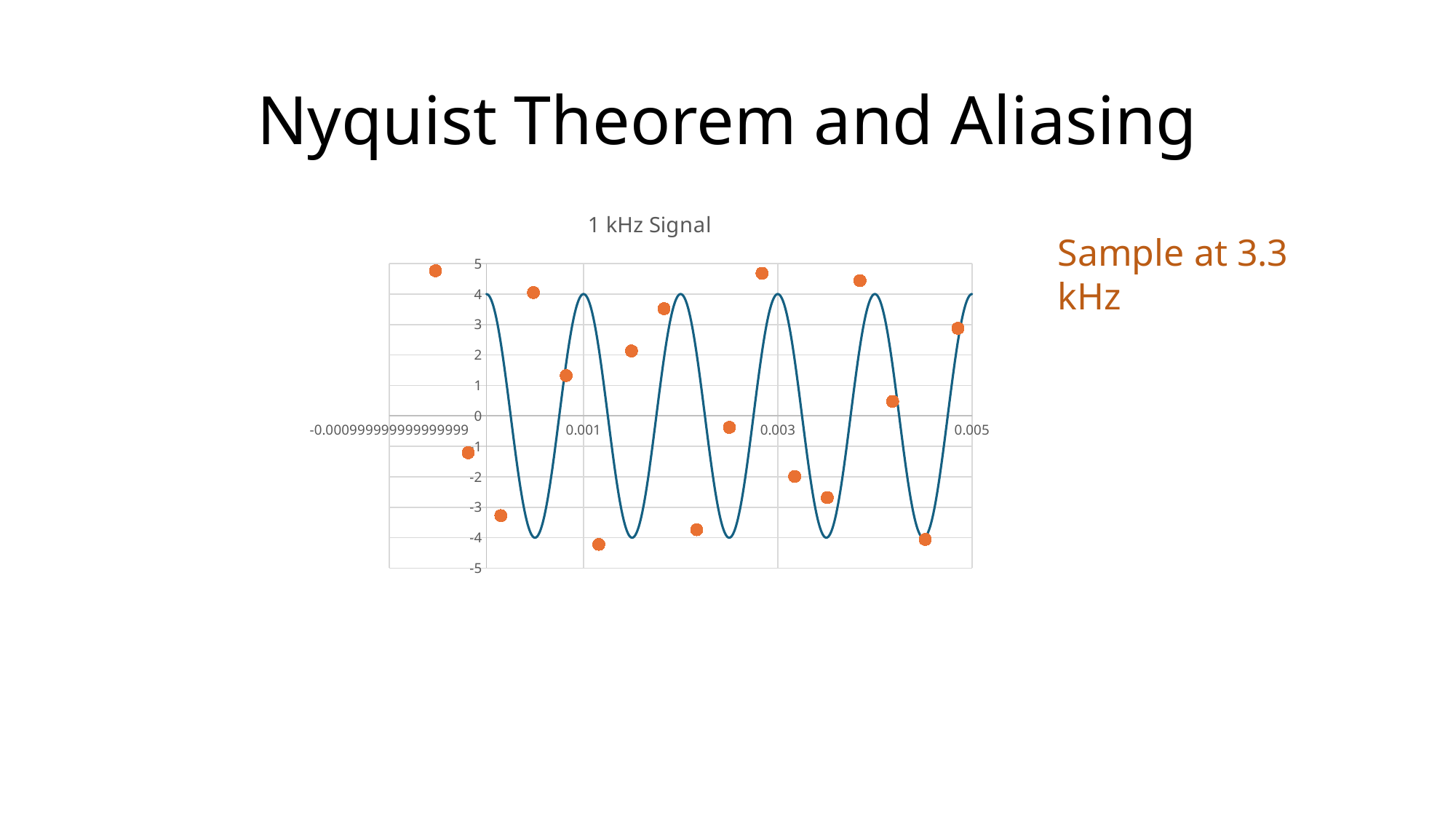
How many orange sample points are plotted on the chart? 17 What is the title of the chart? 1 kHz Signal How many troughs (minimum dips) does the blue line have across the chart? 5 What is the lowest value reached by the blue line? -4 Is the value of the orange point near x = 0.0031 greater or less than 0? less Is the value of the leftmost orange point (near x = -0.0005) greater or less than 4? greater What is the highest value reached by the blue line? 4 Is the value of the orange point just left of x = 0.001 (near x = 0.0007) greater or less than 0? greater What is the maximum value shown on the vertical axis? 5 What kind of chart is shown on the slide? line chart with scatter points